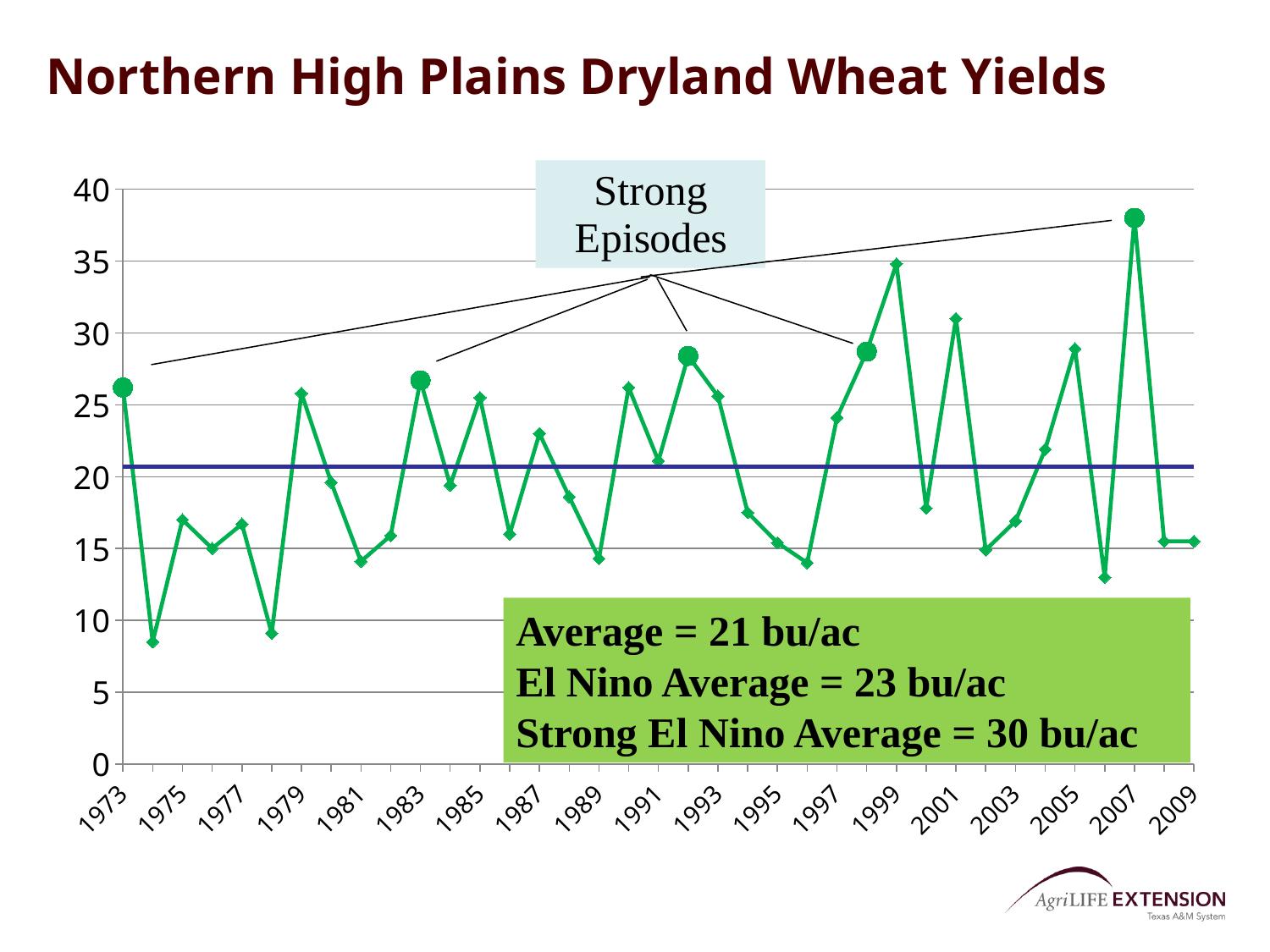
Is the yield for 2007 greater or less than 35? greater Which year has the larger yield, 1974 or 1979? 1979 Which year has the larger yield, 2007 or 1999? 2007 What kind of chart is shown on the slide? line chart Is the yield for 1974 greater or less than 10? less According to the text box on the chart, what is the Strong El Nino average yield? 30 bu/ac What is the title of the chart? Northern High Plains Dryland Wheat Yields Is the yield for 1999 greater or less than 30? greater How many points on the chart are marked as Strong Episodes? 5 Which year has the highest wheat yield on the chart? 2007